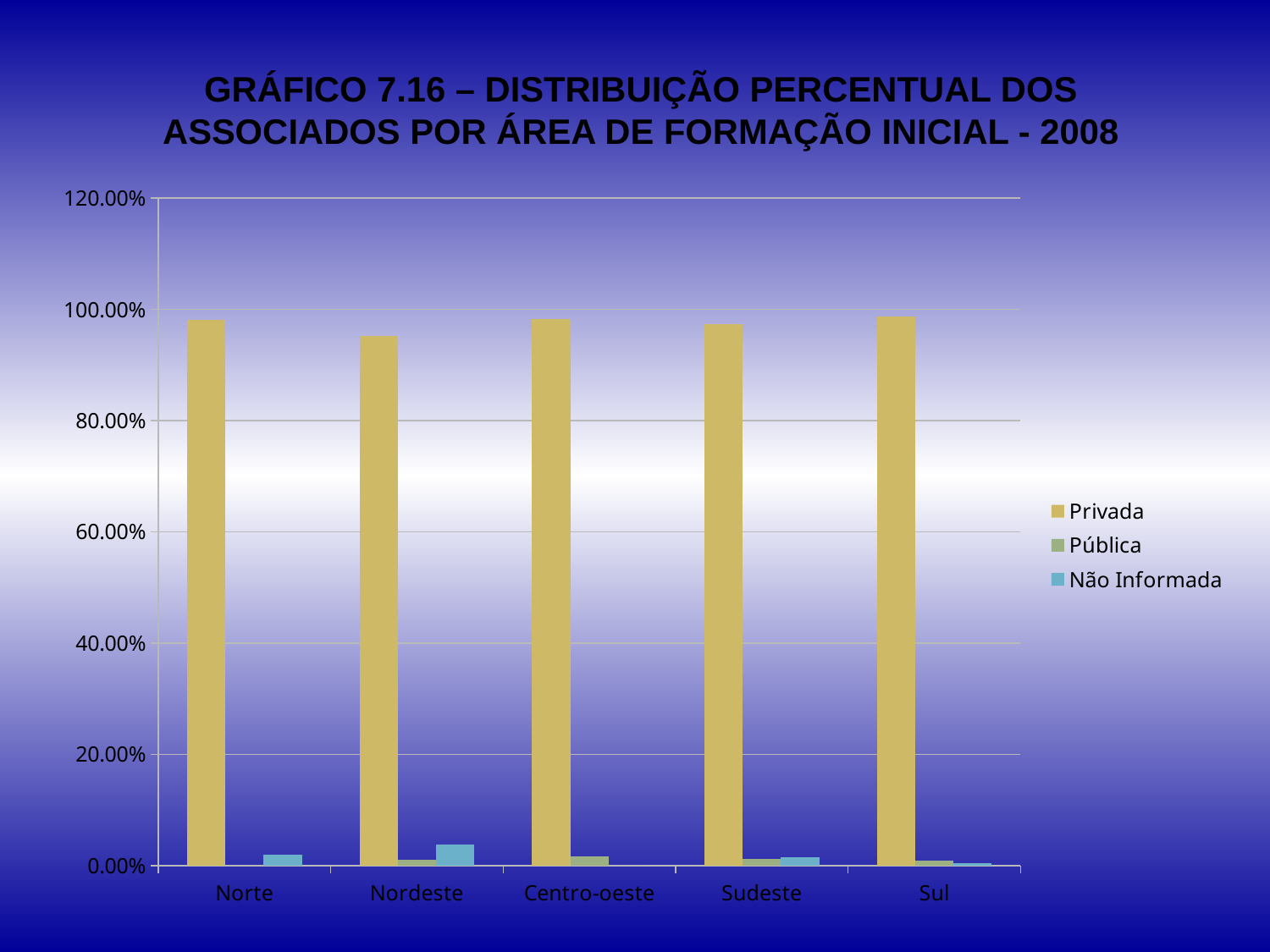
Is the value for Não Informada in Nordeste greater or less than 20.00%? less Which region has the lowest value for the Privada series? Nordeste In Norte, which is larger: the Não Informada value or the Pública value? Não Informada Is the value for Privada in Norte greater or less than 80.00%? greater Which series is shown in gold/yellow bars? Privada Which region has the highest value for the Não Informada series? Nordeste How many series does the legend list? 3 How many regions (categories) are shown on the x axis? 5 What year is referenced in the chart title? 2008 Is the value for Privada in Nordeste greater or less than 100.00%? less What kind of chart is shown on the slide? bar chart In Sudeste, which is larger: the Privada value or the Pública value? Privada